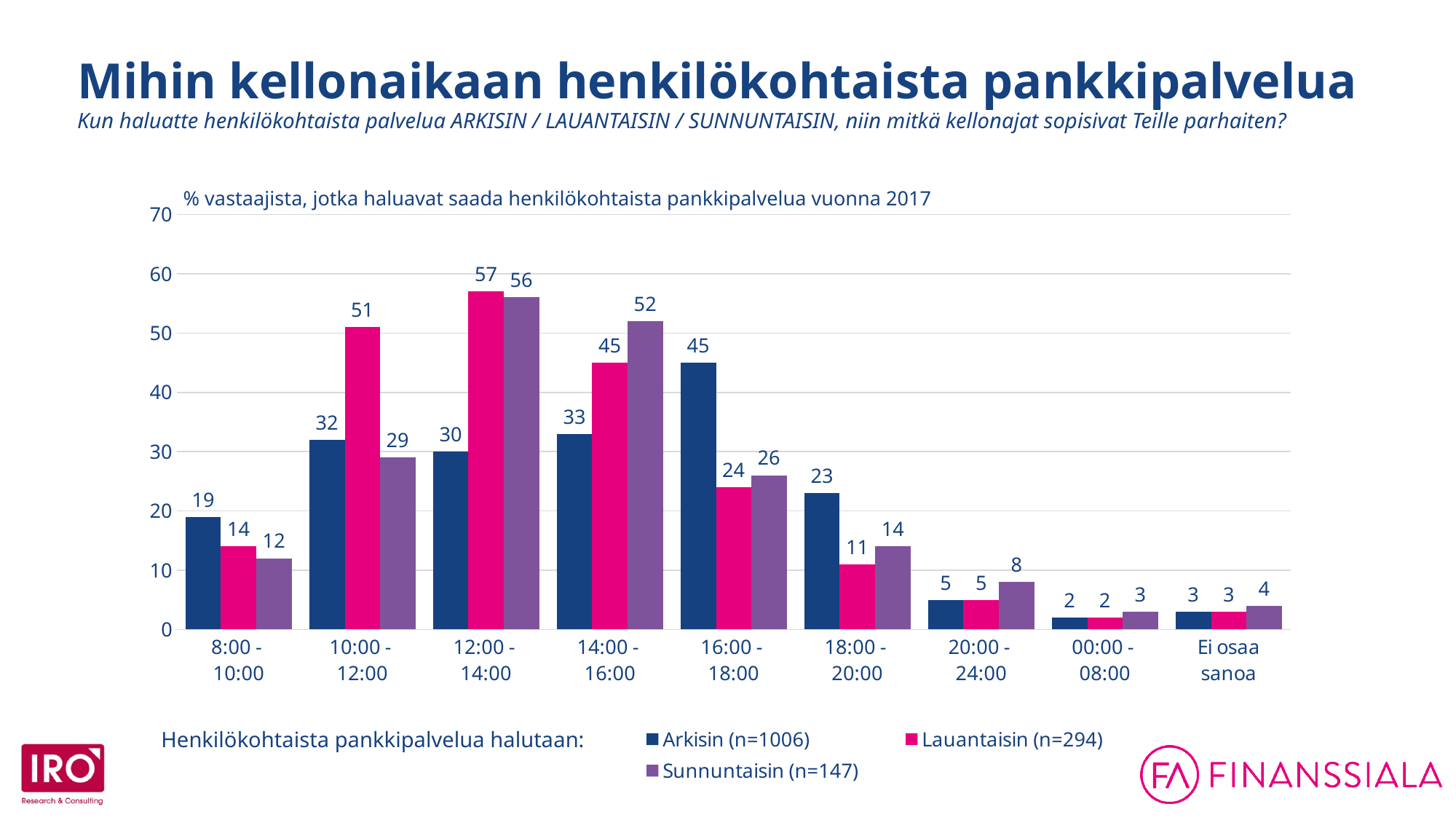
Which time category has the lowest value for Arkisin (n=1006)? 00:00 - 08:00 What is the value for Lauantaisin (n=294) in the 10:00 - 12:00 category? 51 What is the difference between the Arkisin (n=1006) and Lauantaisin (n=294) values in the 16:00 - 18:00 category? 21 In the 10:00 - 12:00 category, which series has the larger value: Arkisin (n=1006) or Sunnuntaisin (n=147)? Arkisin (n=1006) How many time categories are shown on the x axis? 9 Which time category has the highest value for Lauantaisin (n=294)? 12:00 - 14:00 How many series does the legend list? 3 What is the value for Sunnuntaisin (n=147) in the 14:00 - 16:00 category? 52 What kind of chart is shown on the slide? Bar chart What colour are the bars for Lauantaisin (n=294)? Pink What is the value for Arkisin (n=1006) in the 16:00 - 18:00 category? 45 Do the Arkisin (n=1006) values rise or fall from 16:00 - 18:00 to 00:00 - 08:00? Fall